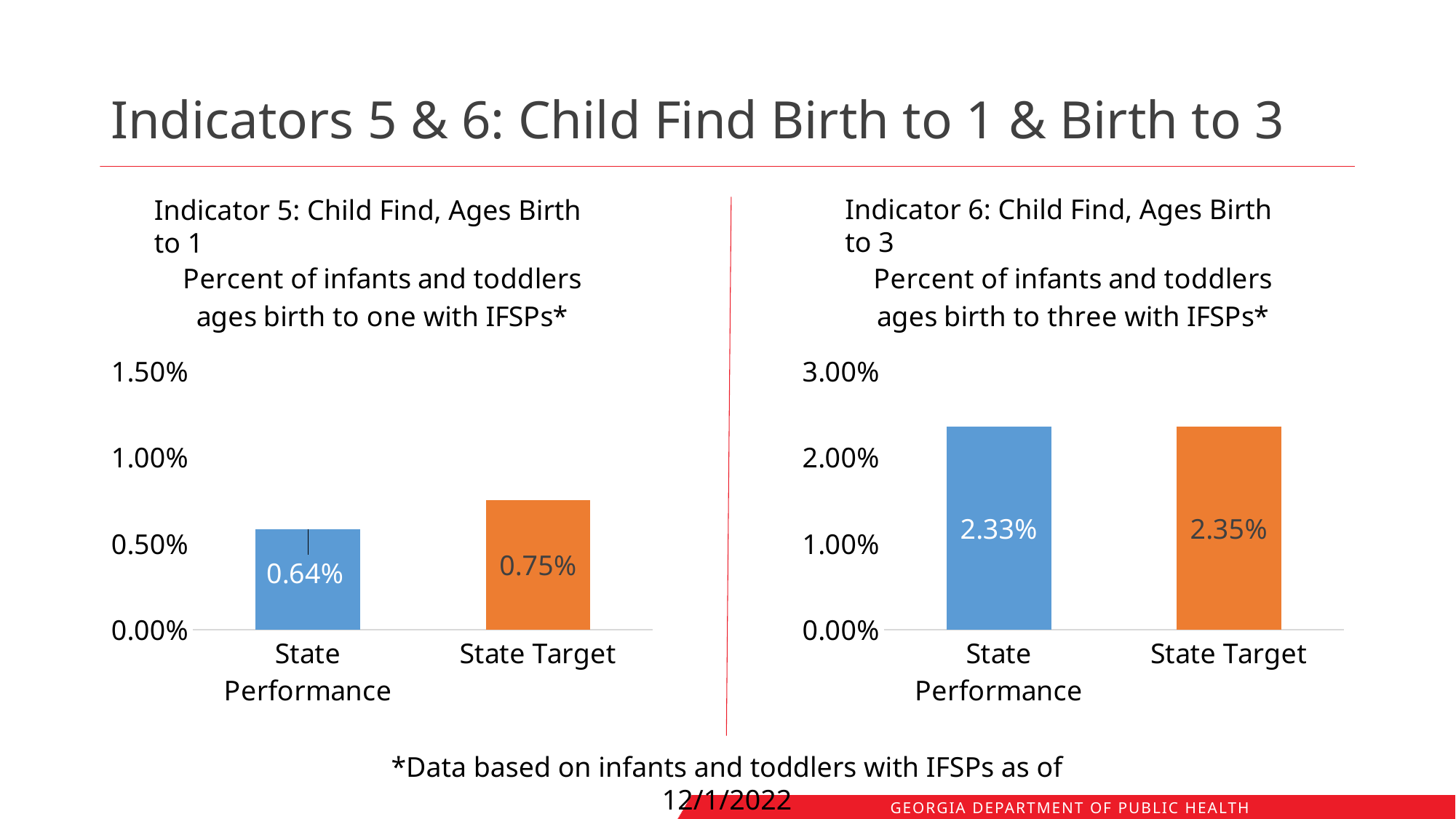
In the Indicator 6 chart (right), what is the difference between State Target and State Performance? 0.02% In the Indicator 5 chart (left), what is the value for State Target? 0.75% In the Indicator 6 chart (right), is the value for State Target greater or less than 2.00%? greater In the Indicator 5 chart (left), is the value for State Performance greater or less than 1.00%? less What is the highest value shown on the y-axis of the Indicator 6 chart (right)? 3.00% In the Indicator 6 chart (right), what is the value for State Target? 2.35% In the Indicator 5 chart (left), what is the difference between State Target and State Performance? 0.11% In the Indicator 6 chart (right), what is the value for State Performance? 2.33% How many categories are shown in the Indicator 6 chart (right)? 2 In the Indicator 5 chart (left), what is the value for State Performance? 0.64% What type of chart is the Indicator 5 chart (left)? Bar chart In the Indicator 5 chart (left), which category has the higher value? State Target